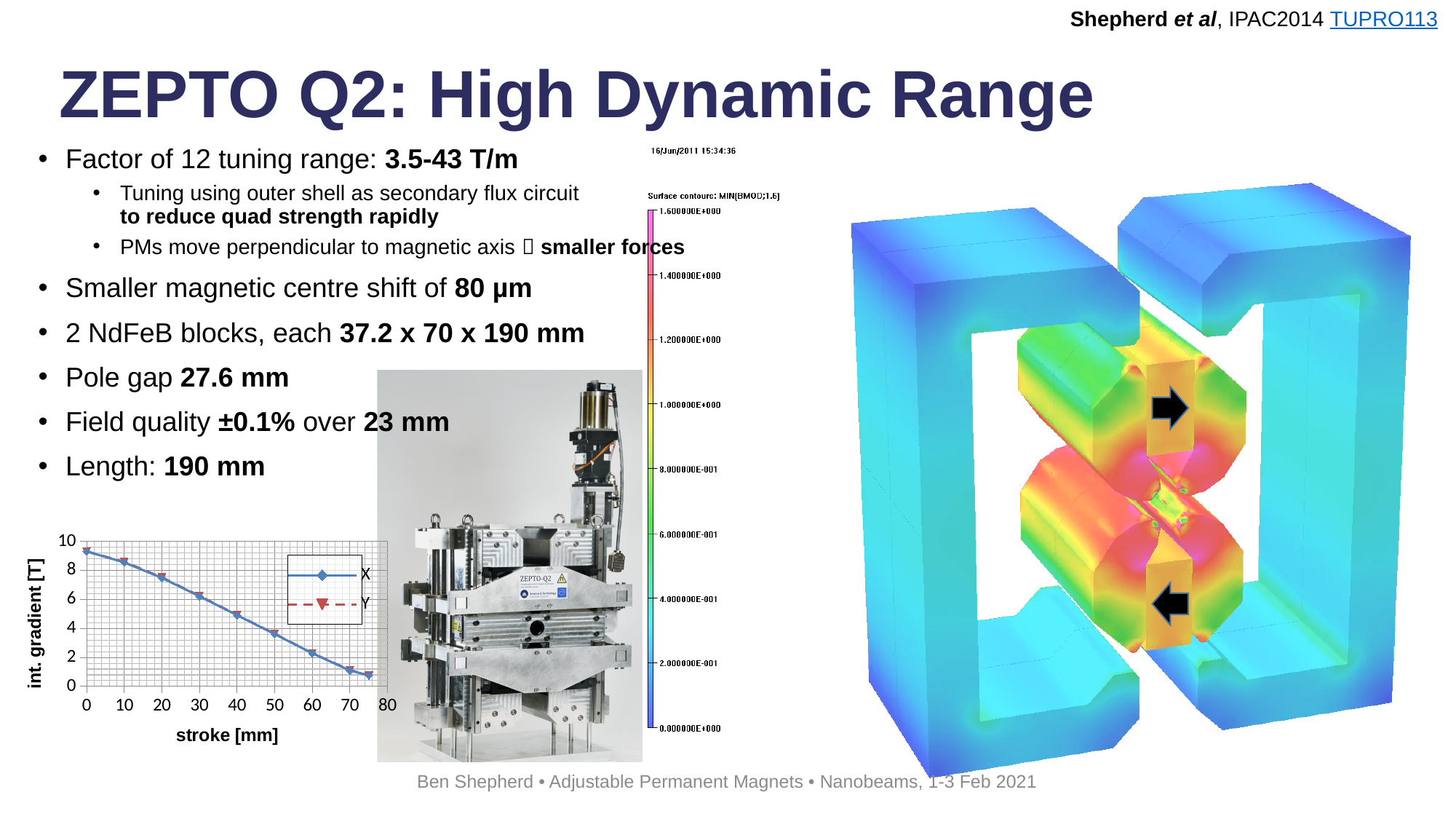
Is the int. gradient at a stroke of 70 mm greater or less than 2 T? less Is the int. gradient at a stroke of 20 mm greater or less than 6 T? greater What are the two series named in the legend of the int. gradient chart? X and Y What is the label of the y axis of the int. gradient chart? int. gradient [T] How many series does the legend of the int. gradient chart list? 2 Which stroke gives a larger int. gradient, 10 mm or 50 mm? 10 mm Is the int. gradient at a stroke of 60 mm greater or less than 4 T? less What kind of chart is the plot of int. gradient versus stroke? line chart At which stroke value is the int. gradient highest? 0 mm Does the integrated gradient rise or fall as the stroke increases? fall